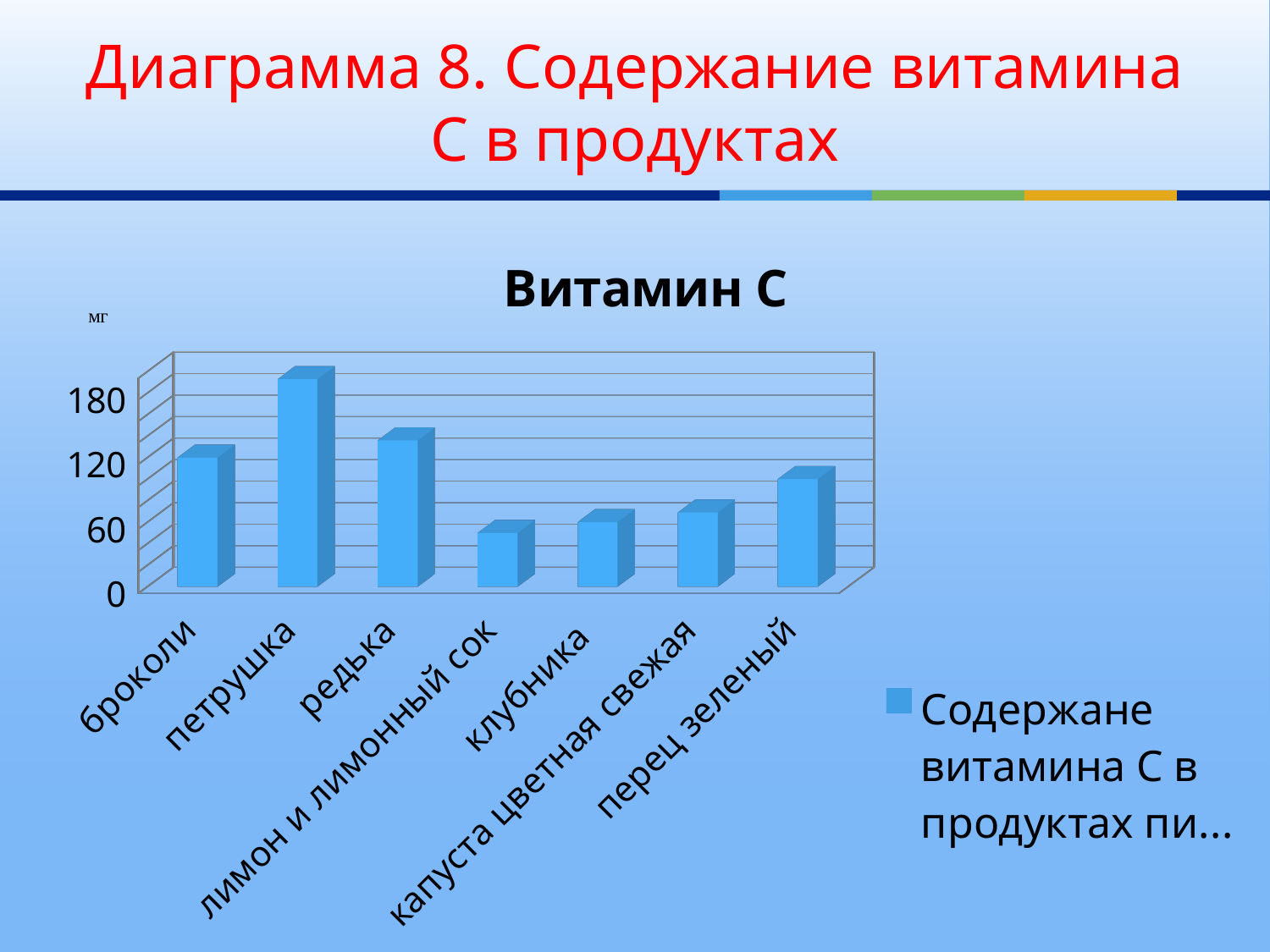
How many series does the chart legend list? 1 Which has a higher value, броколи or клубника? броколи What kind of chart is shown on the slide? bar chart Which product has the highest vitamin C content in the chart? петрушка How many product categories are shown on the x axis of the chart? 7 Is the value for редька greater or less than 120? greater What unit is shown on the vertical axis of the chart? мг Is the value for петрушка greater or less than 180? greater What is the title of the chart? Витамин С Is the value for перец зеленый greater or less than 120? less Which has a higher value, петрушка or редька? петрушка